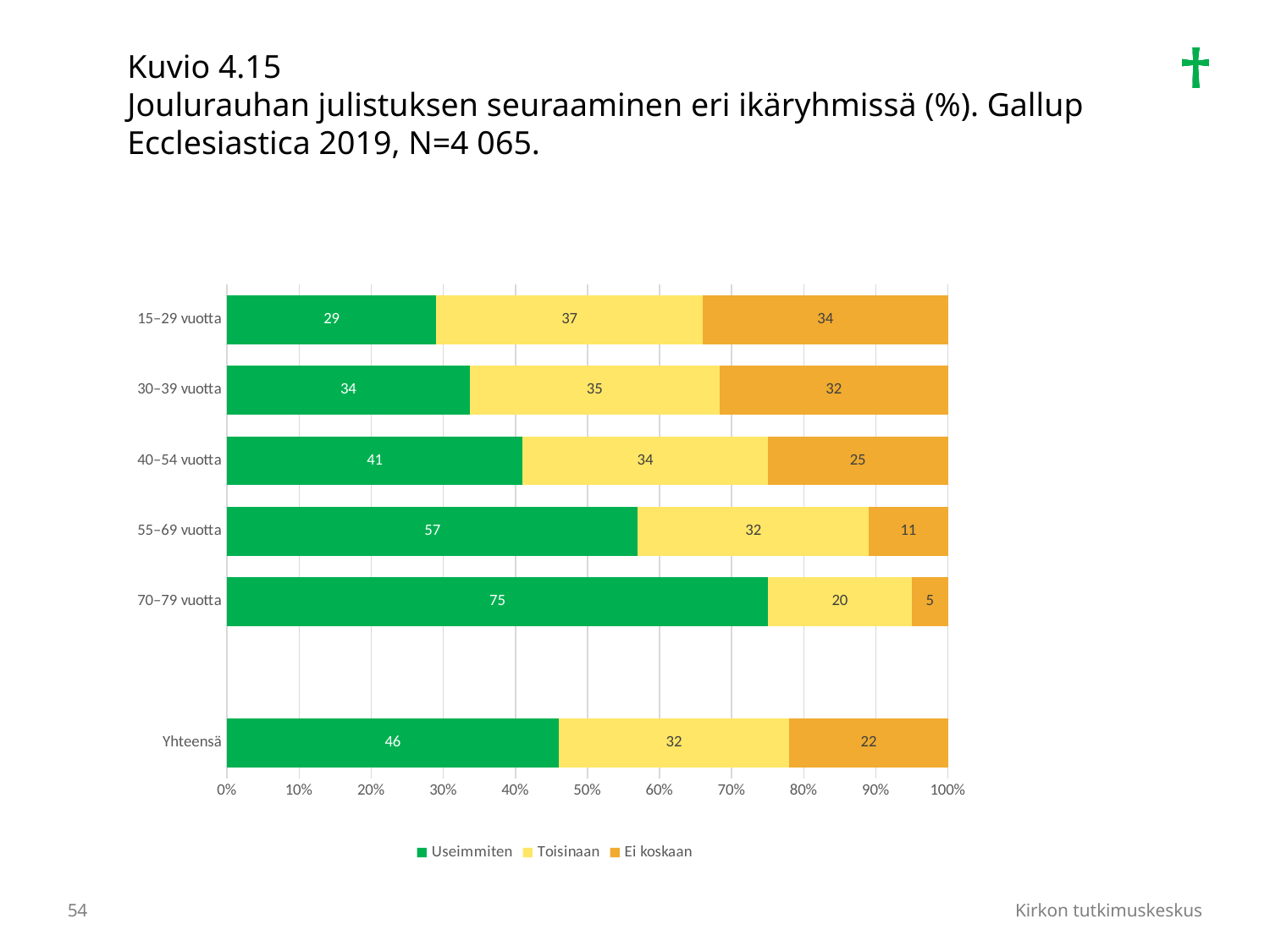
What is the 'Ei koskaan' value for the 15–29 vuotta age group? 34 Which series is shown in green in the legend? Useimmiten Which is larger: the 'Toisinaan' value for 15–29 vuotta or for 30–39 vuotta? 15–29 vuotta How many series does the legend list? 3 How many categories are shown on the vertical axis? 6 Which age group has the lowest 'Ei koskaan' value? 70–79 vuotta Does the 'Useimmiten' value rise or fall as the age groups get older, from 15–29 vuotta to 70–79 vuotta? Rise What kind of chart is shown on the slide? Stacked bar chart What is the 'Toisinaan' value for Yhteensä? 32 Which age group has the highest 'Useimmiten' value? 70–79 vuotta What is the 'Useimmiten' value for the 70–79 vuotta age group? 75 What is the difference between the 'Useimmiten' values for 55–69 vuotta and 40–54 vuotta? 16